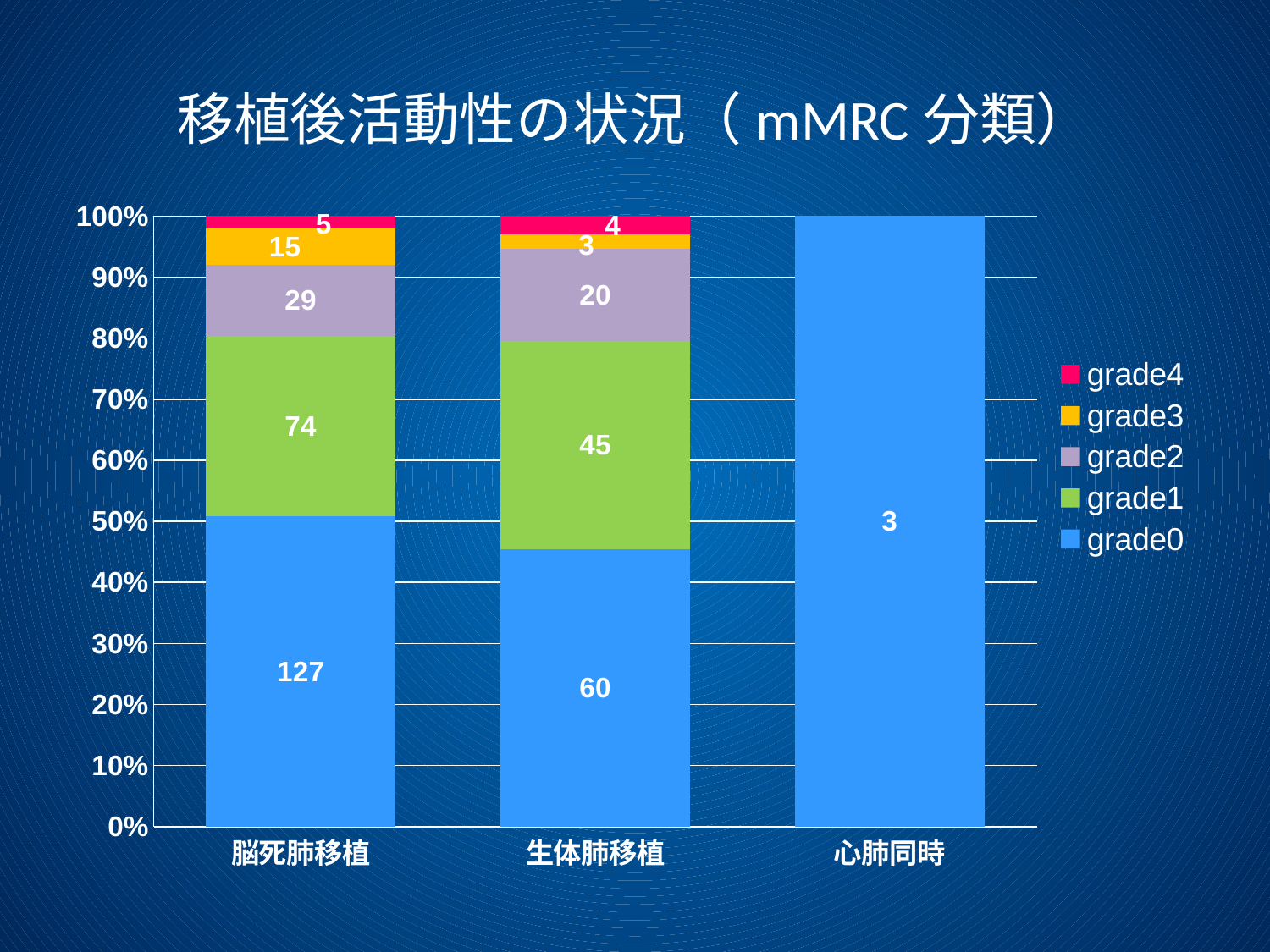
What is the difference between the grade0 values for 脳死肺移植 and 生体肺移植? 67 What is the total of all grade values for the 脳死肺移植 bar? 250 Which is larger, the grade3 value for 脳死肺移植 or the grade3 value for 生体肺移植? 脳死肺移植 What is the grade1 value for 生体肺移植? 45 What is the grade0 value for 脳死肺移植? 127 How many categories are shown on the x axis? 3 What is the title of the chart? 移植後活動性の状況（mMRC分類） Is the grade0 share of the 生体肺移植 bar greater or less than 50%? less What is the grade2 value for 脳死肺移植? 29 What is the grade0 value for 心肺同時? 3 How many series does the legend list? 5 What kind of chart is shown on the slide? stacked bar chart